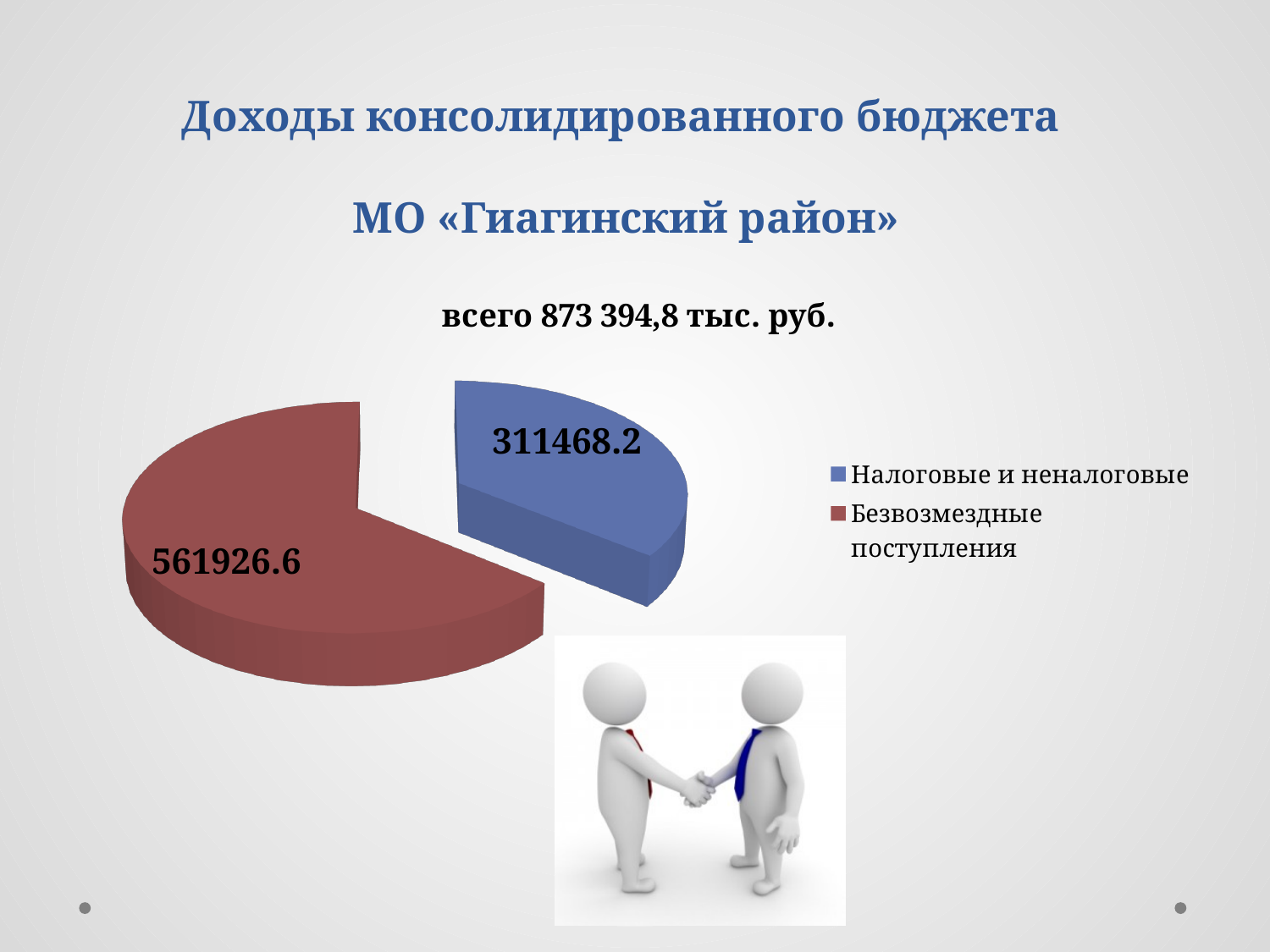
How many entries does the legend list? 2 What colour is the slice for Безвозмездные поступления? Red Which category has the smallest slice in the pie chart? Налоговые и неналоговые Which category has the largest slice in the pie chart? Безвозмездные поступления What kind of chart is shown on the slide? Pie chart Which is larger: Налоговые и неналоговые or Безвозмездные поступления? Безвозмездные поступления What is the total of the two slices, as stated on the slide? 873 394,8 тыс. руб. How many slices does the pie chart have? 2 What is the difference between the values for Безвозмездные поступления and Налоговые и неналоговые? 250458.4 What share of the total does Налоговые и неналоговые represent? 35.7% What is the value for Безвозмездные поступления in the pie chart? 561926.6 What is the value for Налоговые и неналоговые in the pie chart? 311468.2